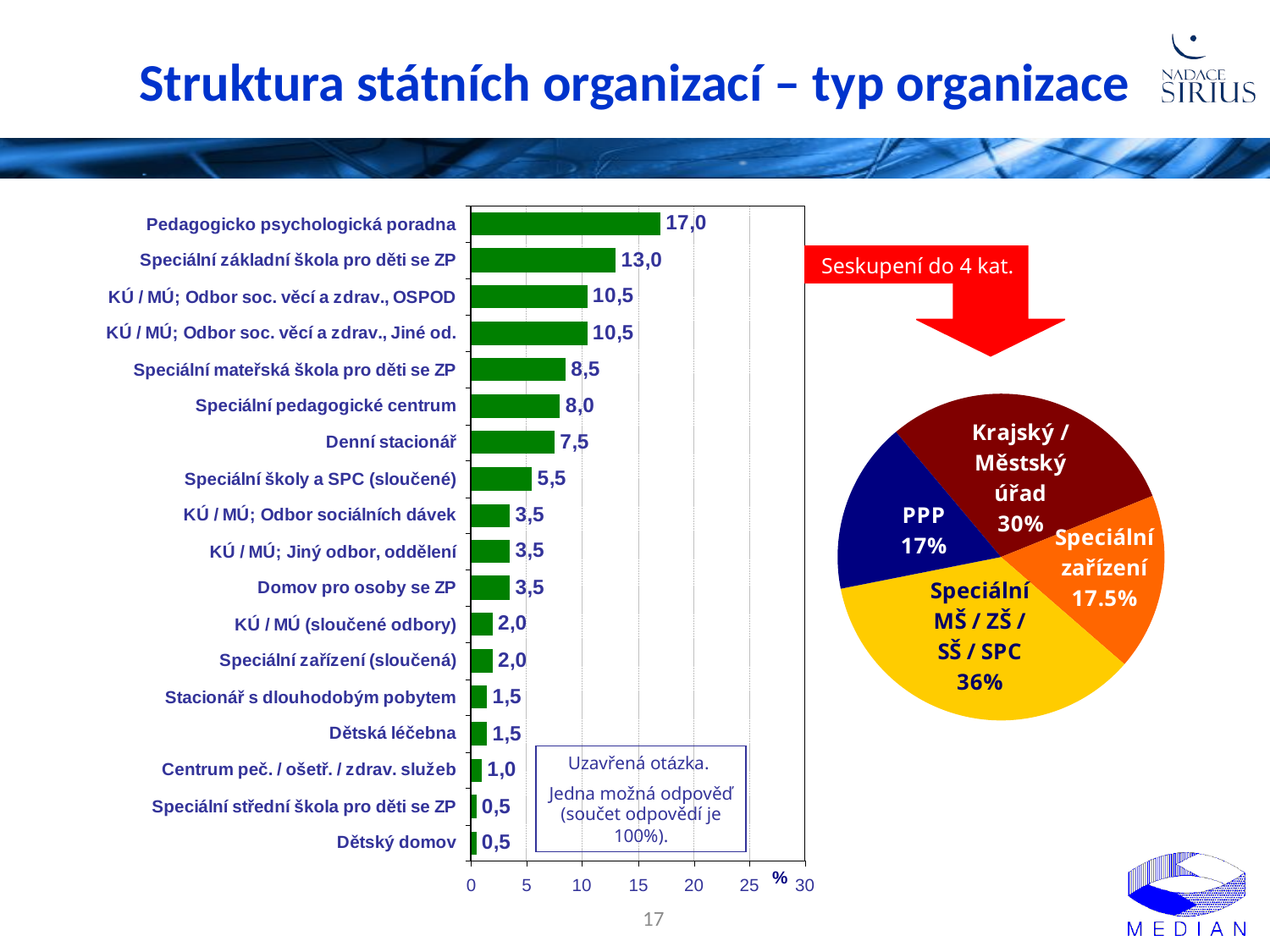
How many slices does the pie chart on the right have? 4 What kind of chart is the chart on the left of the slide? bar chart In the pie chart on the right, which slice is the smallest? PPP What kind of chart is the chart on the right of the slide? pie chart In the bar chart on the left, what is the difference between the values for Pedagogicko psychologická poradna and Speciální základní škola pro děti se ZP? 4,0 In the bar chart on the left, what is the value for Pedagogicko psychologická poradna? 17,0 How many categories are shown in the bar chart on the left? 18 In the bar chart on the left, which is larger: the value for Speciální mateřská škola pro děti se ZP or the value for Speciální pedagogické centrum? Speciální mateřská škola pro děti se ZP In the pie chart on the right, what share does Speciální MŠ / ZŠ / SŠ / SPC have? 36% In the bar chart on the left, which category has the highest value? Pedagogicko psychologická poradna In the pie chart on the right, what share does Krajský / Městský úřad have? 30% In the bar chart on the left, what is the value for Denní stacionář? 7,5